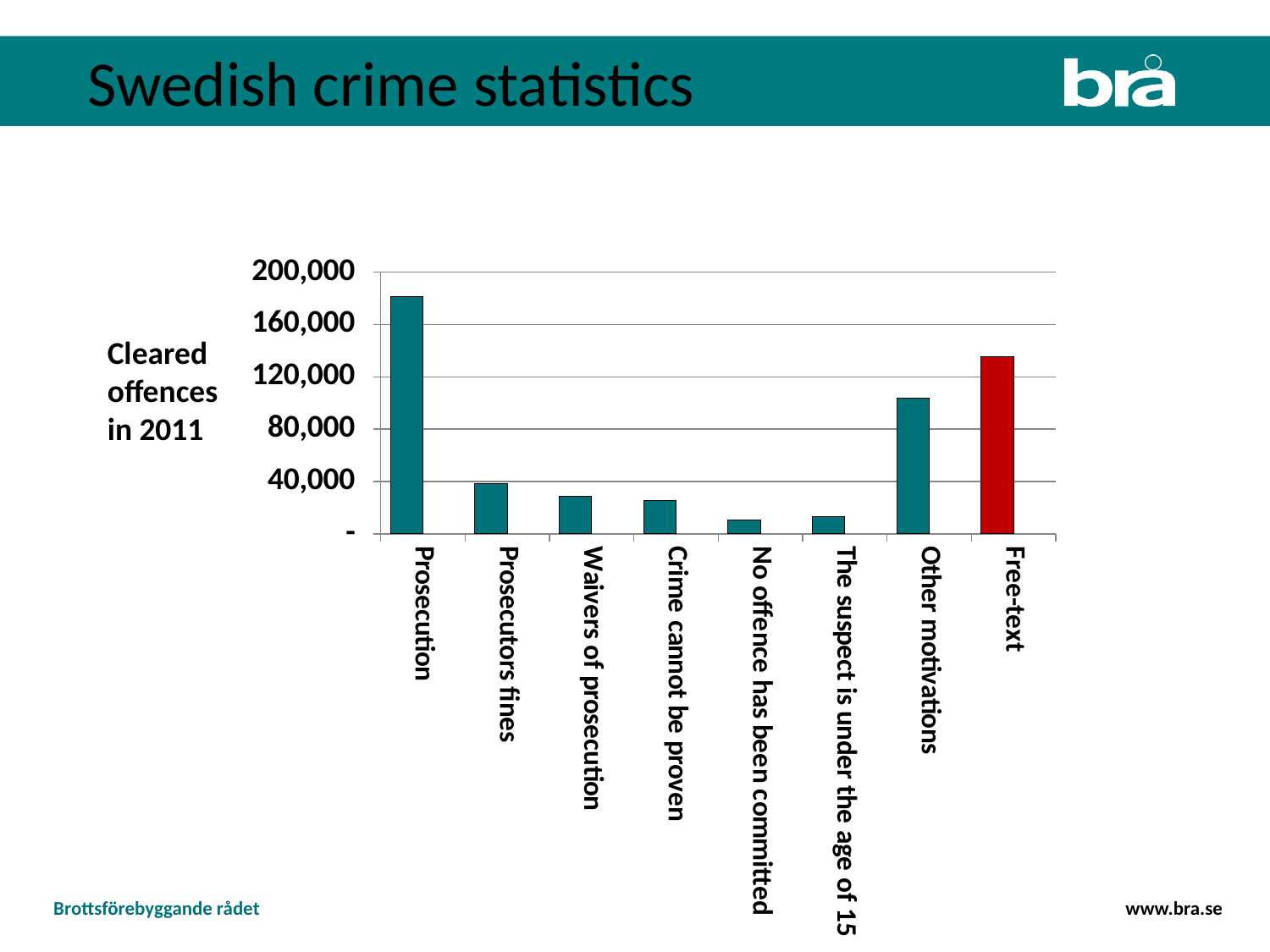
Which is larger, the value for Free-text or the value for Other motivations? Free-text What is the title label shown to the left of the chart? Cleared offences in 2011 Is the value for Other motivations greater or less than 80,000? greater Which is larger, the value for Prosecutors fines or the value for Waivers of prosecution? Prosecutors fines Is the value for Prosecution greater or less than 160,000? greater Is the value for No offence has been committed greater or less than 40,000? less What kind of chart is shown on the slide? bar chart Which category's bar is coloured red in the chart? Free-text How many categories are plotted on the x axis of the chart? 8 Which category has the highest value in the chart? Prosecution